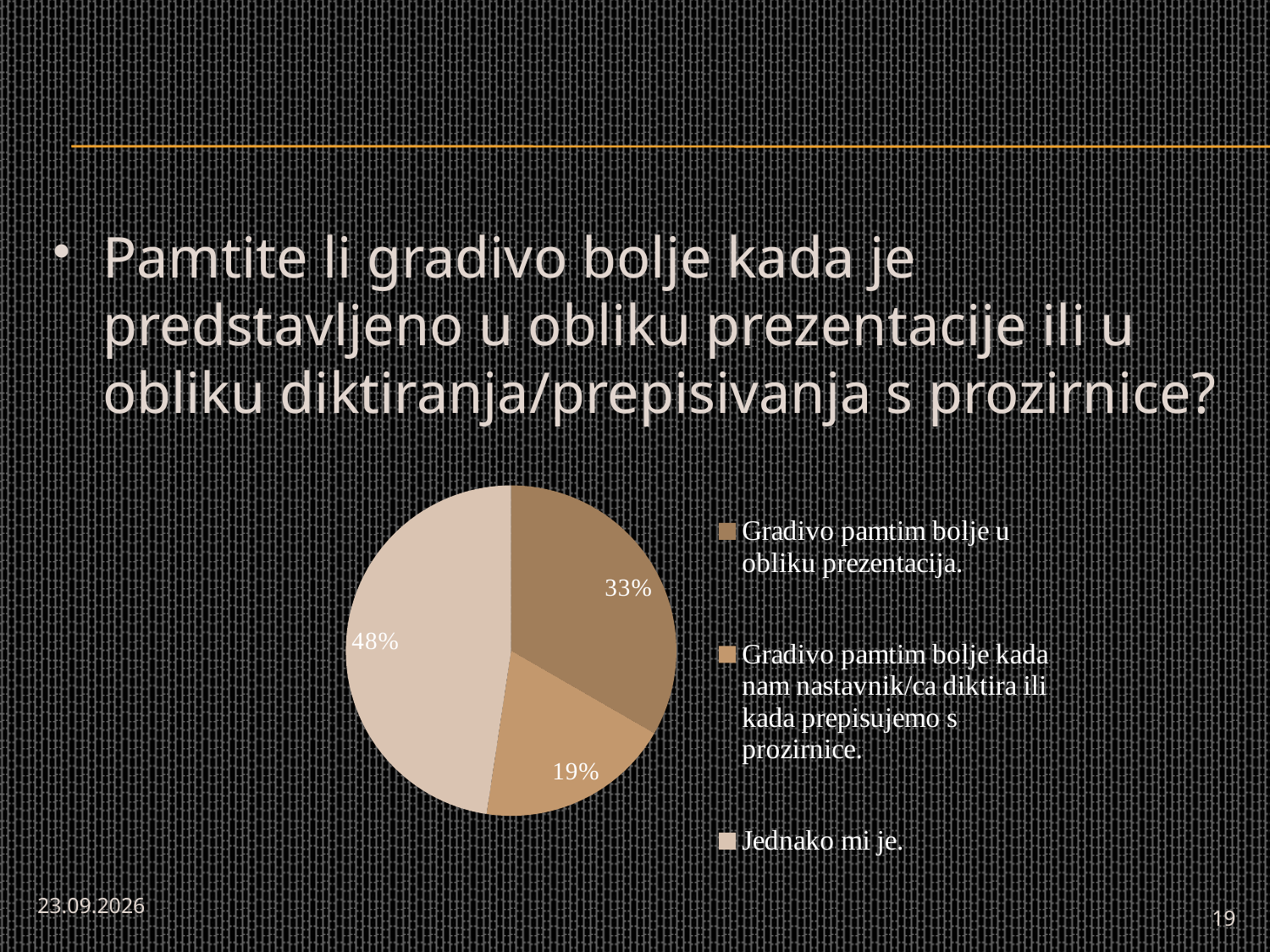
What is the difference in percentage points between the "Jednako mi je." slice and the "Gradivo pamtim bolje u obliku prezentacija." slice? 15% What share of the pie does "Jednako mi je." have? 48% Which legend entry is listed last in the legend? Jednako mi je. How many slices does the pie chart have? 3 Which is larger: the "Gradivo pamtim bolje u obliku prezentacija." slice or the "Gradivo pamtim bolje kada nam nastavnik/ca diktira ili kada prepisujemo s prozirnice." slice? Gradivo pamtim bolje u obliku prezentacija. What is the difference in percentage points between the "Gradivo pamtim bolje u obliku prezentacija." slice and the "Gradivo pamtim bolje kada nam nastavnik/ca diktira ili kada prepisujemo s prozirnice." slice? 14% Which slice of the pie is the smallest? Gradivo pamtim bolje kada nam nastavnik/ca diktira ili kada prepisujemo s prozirnice. Which slice of the pie is the largest? Jednako mi je. What share of the pie does "Gradivo pamtim bolje u obliku prezentacija." have? 33% How many entries does the legend list? 3 What share of the pie does "Gradivo pamtim bolje kada nam nastavnik/ca diktira ili kada prepisujemo s prozirnice." have? 19% What kind of chart is shown on the slide? pie chart